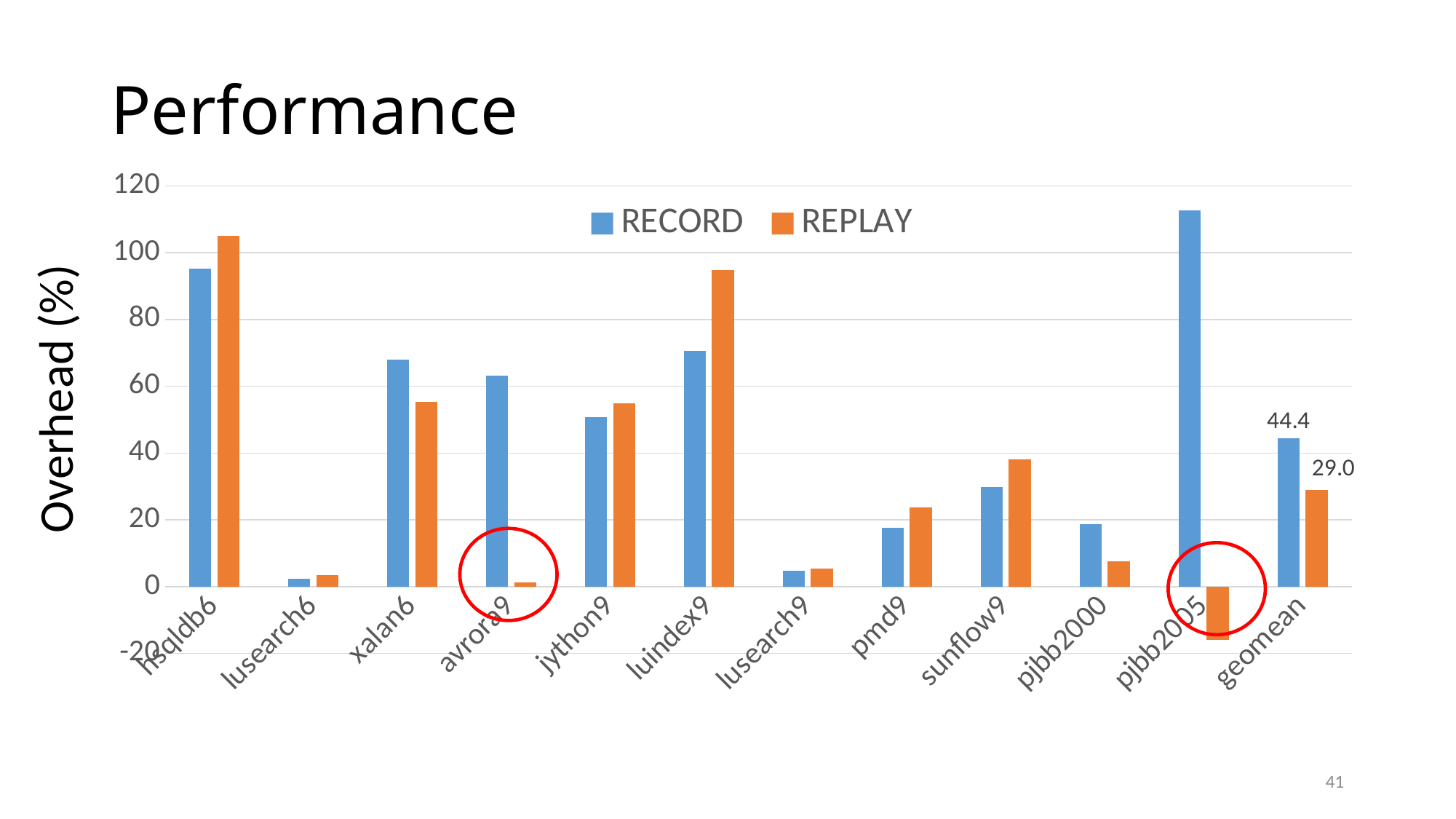
Is the RECORD value for pjbb2005 greater or less than 100? greater What is the RECORD value for geomean? 44.4 Which is larger for luindex9, the RECORD value or the REPLAY value? REPLAY How many categories are shown on the x axis? 12 What is the REPLAY value for geomean? 29.0 Which category has the lowest REPLAY overhead? pjbb2005 Is the REPLAY value for xalan6 greater or less than 60? less How many series does the legend list? 2 What kind of chart is shown on the slide? bar chart Which category has the highest REPLAY overhead? hsqldb6 Which category has the highest RECORD overhead? pjbb2005 What is the difference between the RECORD and REPLAY values for geomean? 15.4